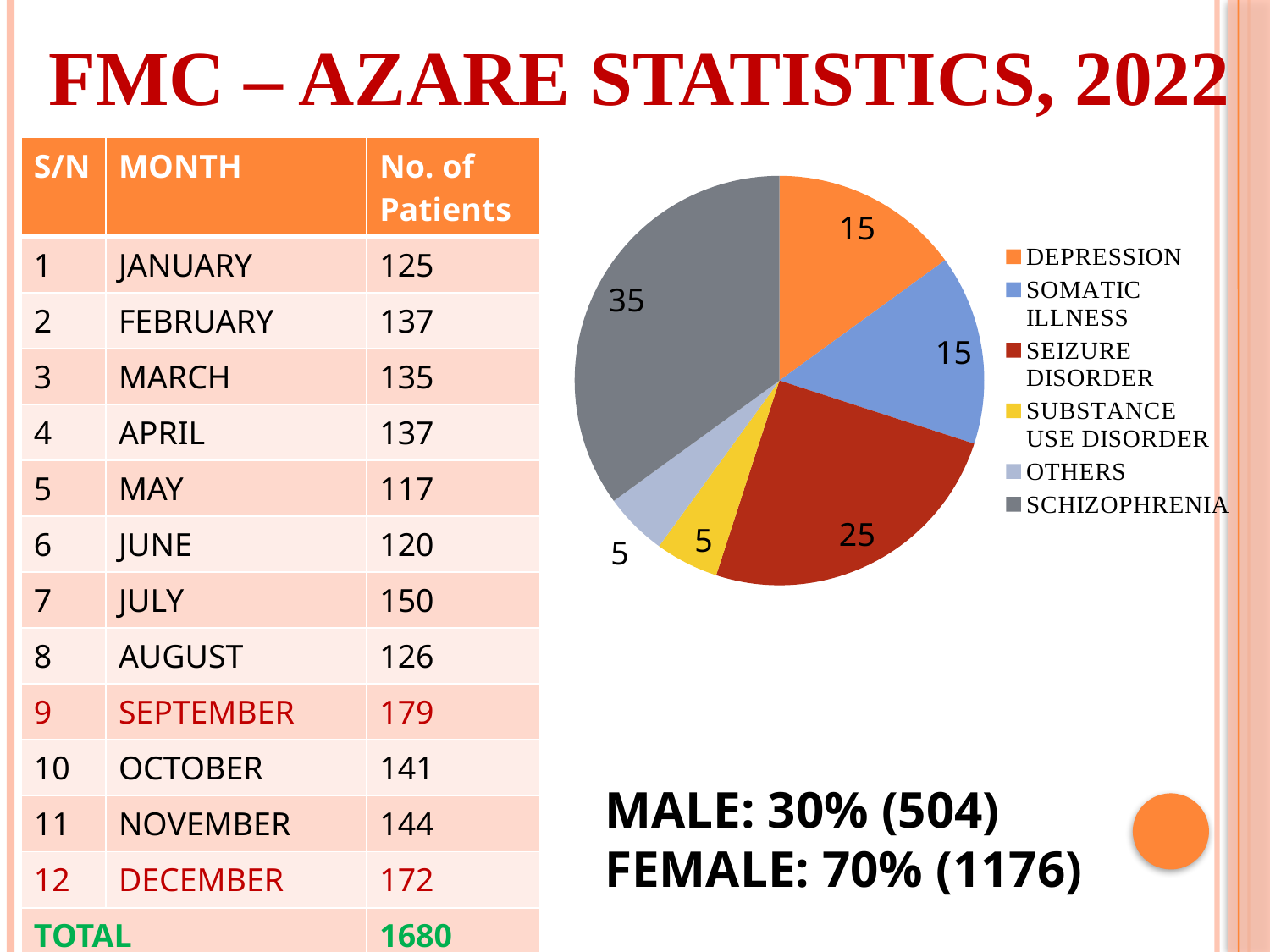
Which is larger in the pie chart, Seizure Disorder or Somatic Illness? Seizure Disorder What is the difference between the Schizophrenia value and the Seizure Disorder value in the pie chart? 10 What is the value shown for the Substance Use Disorder slice of the pie chart? 5 What is the value shown for the Depression slice of the pie chart? 15 Which category has the largest slice in the pie chart? Schizophrenia How many slices does the pie chart have? 6 What share of the pie chart does the Schizophrenia slice represent? 35% What is the value shown for the Schizophrenia slice of the pie chart? 35 How many entries does the pie chart legend list? 6 What colour is the Schizophrenia slice in the pie chart? grey What is the value shown for the Seizure Disorder slice of the pie chart? 25 What kind of chart is shown on the slide? pie chart